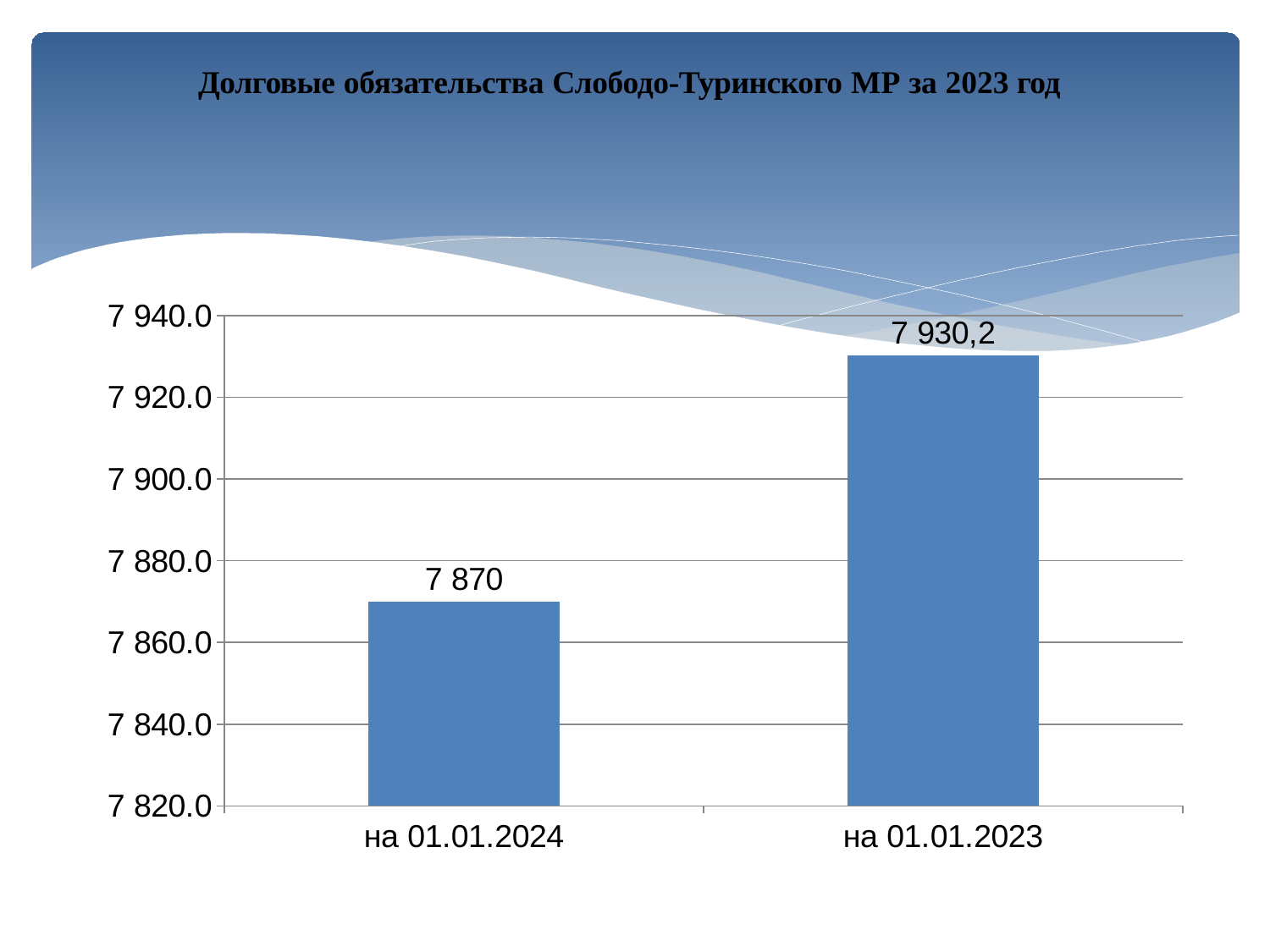
How many categories are shown on the chart? 2 Is the value for на 01.01.2024 greater or less than 7 880.0? less What is the value for на 01.01.2024? 7 870 Which category has the highest value? на 01.01.2023 What is the value for на 01.01.2023? 7 930,2 Which category has the lowest value? на 01.01.2024 Do the values rise or fall from left to right along the x axis? rise What is the title of the chart? Долговые обязательства Слободо-Туринского МР за 2023 год What is the difference between the values for на 01.01.2023 and на 01.01.2024? 60,2 What kind of chart is shown on the slide? bar chart Which is larger, the value for на 01.01.2024 or the value for на 01.01.2023? на 01.01.2023 Is the value for на 01.01.2023 greater or less than 7 920.0? greater